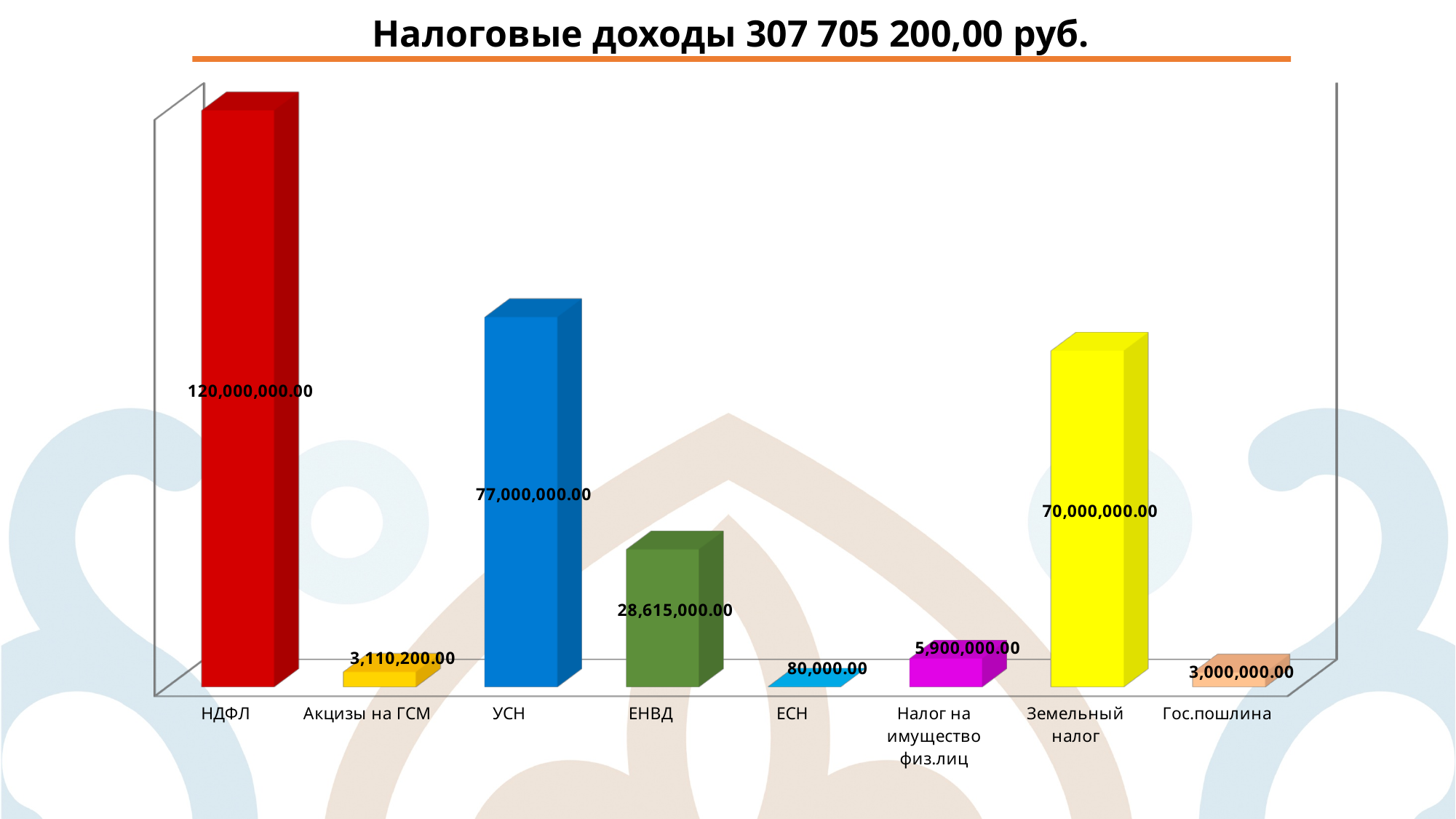
What is the value for НДФЛ? 120,000,000.00 What is the difference between the values for УСН and Земельный налог? 7,000,000.00 Which is larger, the value for Гос.пошлина or the value for Акцизы на ГСМ? Акцизы на ГСМ What is the title of the chart? Налоговые доходы 307 705 200,00 руб. What is the difference between the values for НДФЛ and УСН? 43,000,000.00 What is the value for ЕНВД? 28,615,000.00 What kind of chart is shown on the slide? Bar chart What is the value for Налог на имущество физ.лиц? 5,900,000.00 Which category has the highest value? НДФЛ How many categories are shown in the chart? 8 Which category has the lowest value? ЕСН What is the value for Акцизы на ГСМ? 3,110,200.00